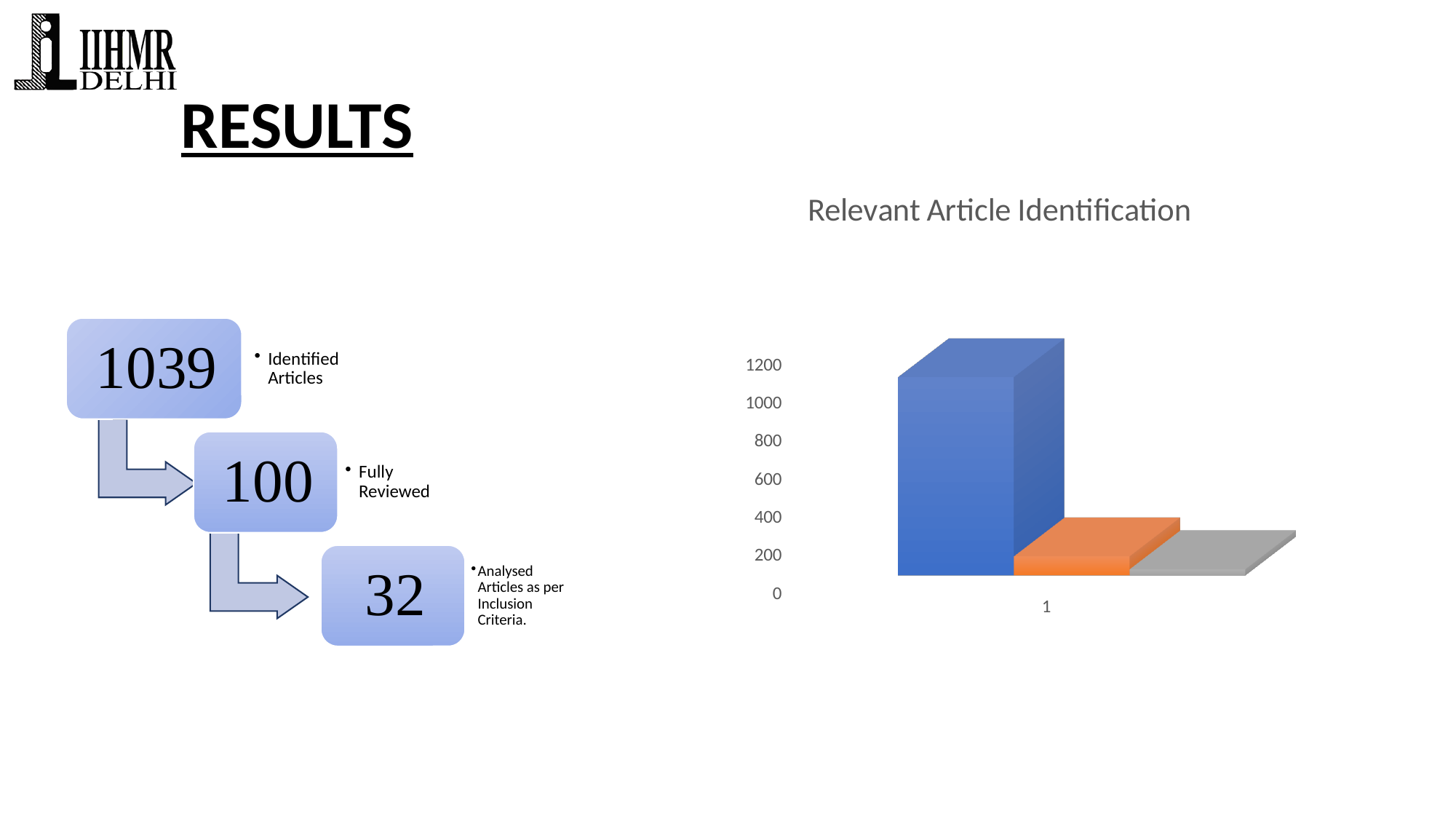
In the "Relevant Article Identification" chart, which coloured bar is the shortest? grey What is the highest value shown on the y axis of the "Relevant Article Identification" chart? 1200 In the "Relevant Article Identification" chart, which is larger, the blue bar or the orange bar? blue bar In the "Relevant Article Identification" chart, is the value of the grey bar greater or less than 200? less In the "Relevant Article Identification" chart, is the value of the orange bar greater or less than 200? less How many categories are shown on the x axis of the "Relevant Article Identification" chart? 1 How many bars are plotted in the "Relevant Article Identification" chart? 3 In the "Relevant Article Identification" chart, is the value of the blue bar greater or less than 1000? greater What is the title of the chart on the right side of the slide? Relevant Article Identification What is the label of the single category on the x axis of the "Relevant Article Identification" chart? 1 What kind of chart is shown under the title "Relevant Article Identification"? bar chart In the "Relevant Article Identification" chart, which coloured bar is the tallest? blue